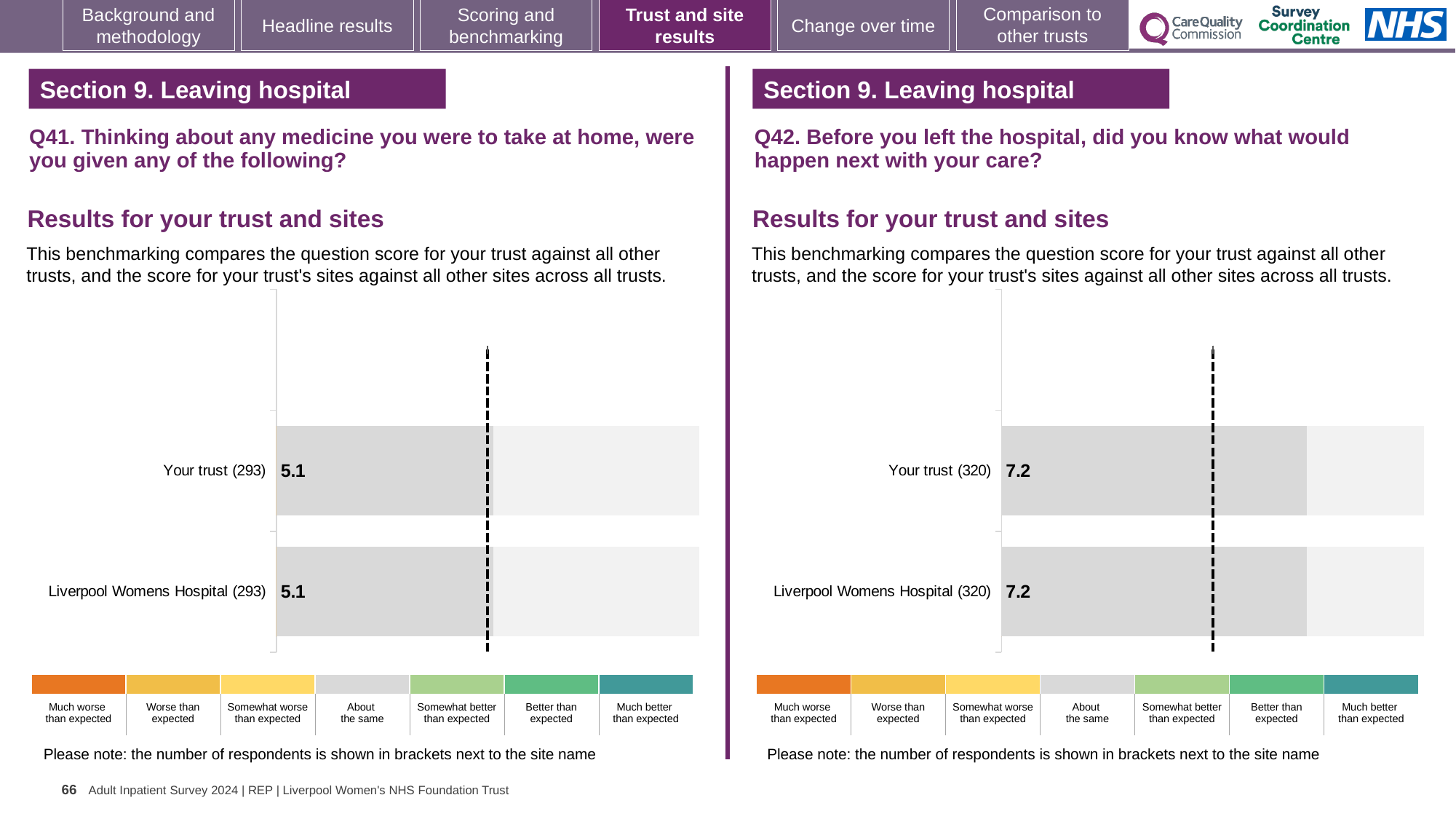
In the Q41 chart on the left, what is the score for Your trust? 5.1 In the Q41 chart on the left, what is the difference between the score for Your trust and the score for Liverpool Womens Hospital? 0 How many categories does the colour key below the Q42 chart on the right list? 7 In the Q41 chart on the left, what is the score for Liverpool Womens Hospital? 5.1 In the Q42 chart on the right, what is the score for Your trust? 7.2 In the Q42 chart on the right, what is the score for Liverpool Womens Hospital? 7.2 In the colour key below the Q41 chart on the left, what colour represents 'Much worse than expected'? Orange In the Q42 chart on the right, how many respondents are shown in brackets for Liverpool Womens Hospital? 320 What kind of chart is used in the Q41 chart on the left? Bar chart Which is larger: the Your trust score in the Q42 chart on the right or the Your trust score in the Q41 chart on the left? Q42 chart on the right How many bars are plotted in the Q42 chart on the right? 2 In the Q41 chart on the left, how many respondents are shown in brackets for Your trust? 293